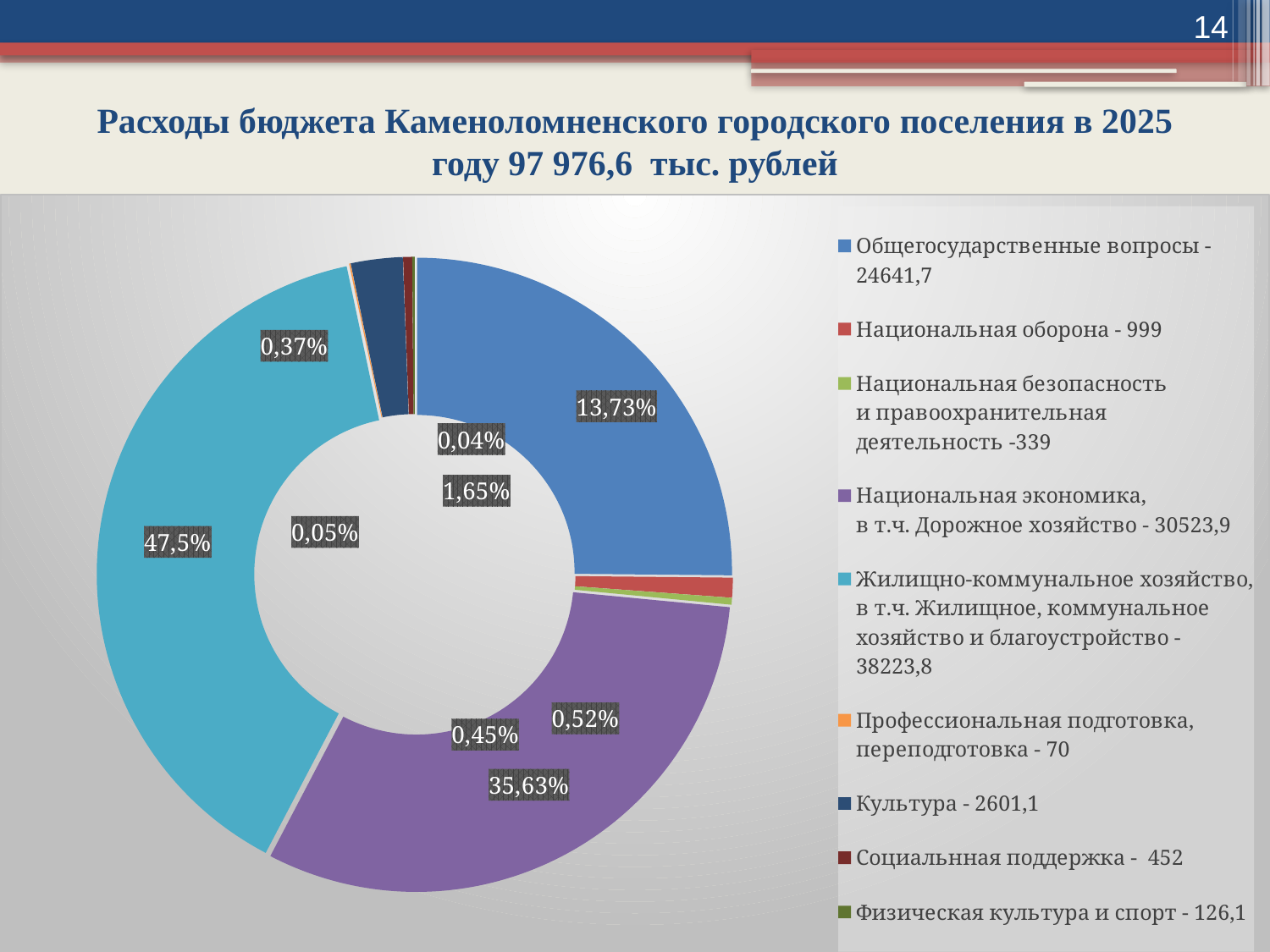
According to the title, what is the total budget expenditure of the Каменоломненское городское поселение in 2025? 97 976,6 тыс. рублей Which category has the largest share of the budget expenditures? Жилищно-коммунальное хозяйство What is the value given in the legend for Культура? 2601,1 What is the difference between the legend values for Жилищно-коммунальное хозяйство (38223,8) and Национальная экономика (30523,9)? 7699,9 How many categories does the legend list? 9 Which is larger: Национальная экономика or Общегосударственные вопросы? Национальная экономика What share of expenditures is labelled for the Жилищно-коммунальное хозяйство slice? 47,5% What share of expenditures is labelled for the Общегосударственные вопросы slice? 13,73% What is the value given in the legend for Профессиональная подготовка, переподготовка? 70 What is the value given in the legend for Национальная оборона? 999 What type of chart is shown on the slide? Doughnut (pie) chart What share of expenditures is labelled for the Национальная экономика slice? 35,63%